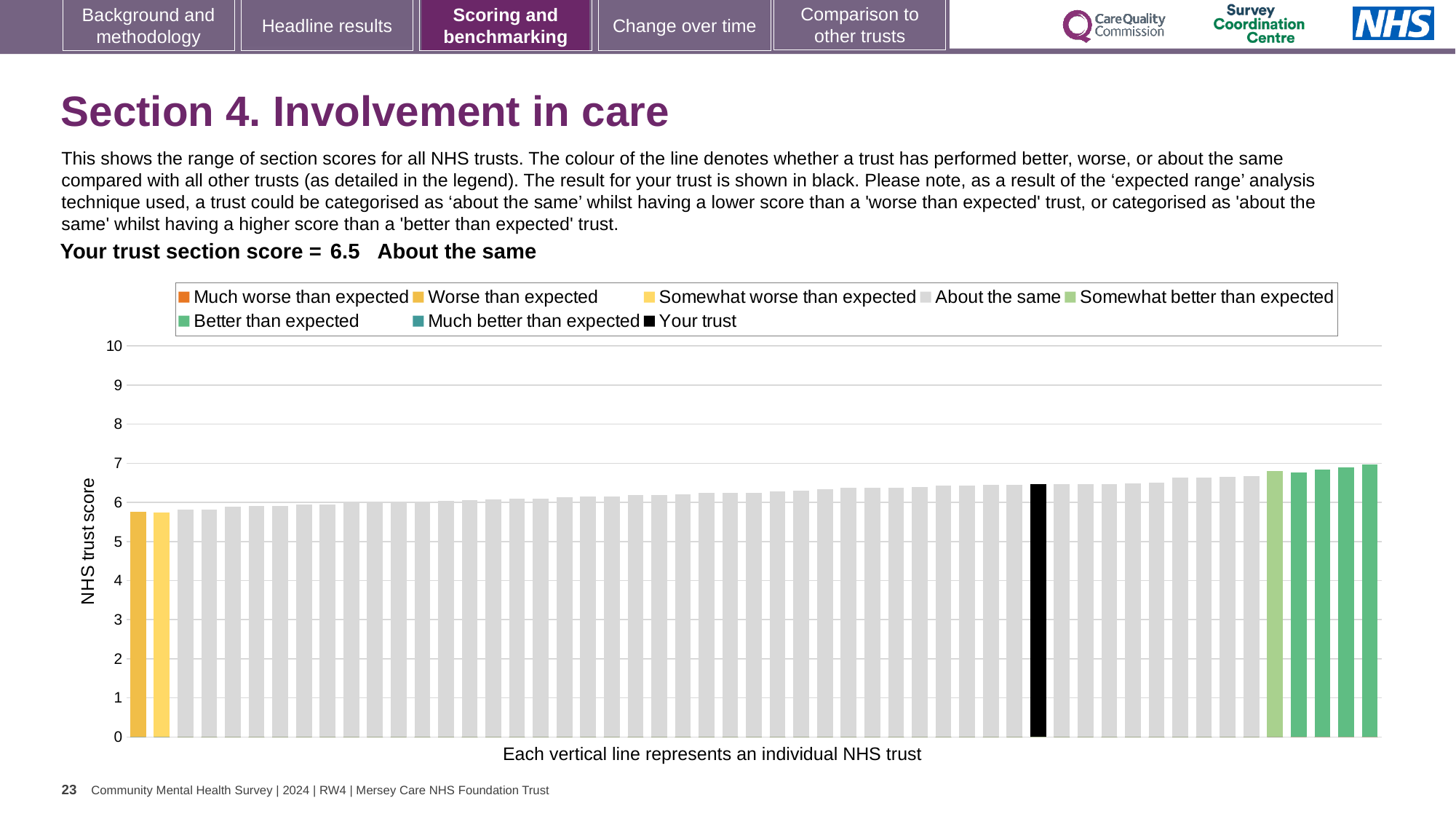
Which bar has the highest value in the chart? the rightmost bar What is the section score for your trust shown on the slide? 6.5 How many entries does the chart legend list? 8 Do the bar values rise or fall from left to right along the x axis? rise What is the label on the vertical axis of the chart? NHS trust score Is the value of the black bar (your trust) greater or less than 6? greater Which performance category is your trust's section score assigned to? About the same Is the value of the leftmost bar greater or less than 5? greater Which is larger: the value of the black bar (your trust) or the value of the leftmost bar? the black bar (your trust) What kind of chart is shown on the slide? bar chart Is the value of the leftmost bar greater or less than 6? less